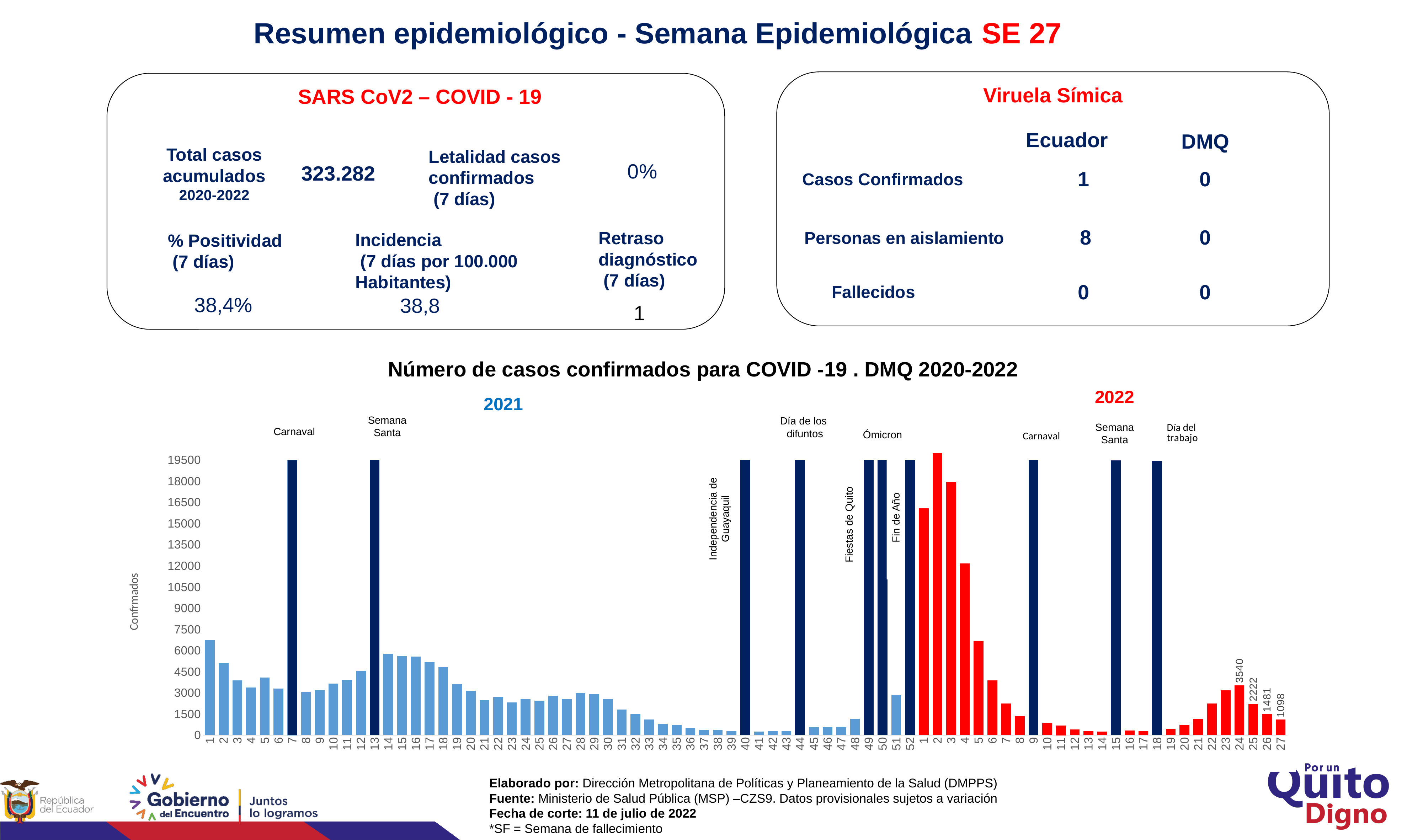
Which week has more confirmed cases, week 24 of 2022 or week 27 of 2022? week 24 of 2022 Do the confirmed cases rise or fall from week 24 to week 27 of 2022? fall Is the value for week 2 of 2022 greater or less than 18000? greater What is the difference in confirmed cases between week 24 and week 25 of 2022? 1318 What type of chart is shown under the title "Número de casos confirmados para COVID -19 . DMQ 2020-2022"? bar chart What is the difference in confirmed cases between week 26 and week 27 of 2022? 383 What is the number of confirmed cases for week 25 of 2022? 2222 What is the number of confirmed cases for week 24 of 2022? 3540 What is the number of confirmed cases for week 27 of 2022? 1098 What colour are the bars for the 2022 weeks? red What is the number of confirmed cases for week 26 of 2022? 1481 Which week of 2022 has the highest number of confirmed cases? week 2